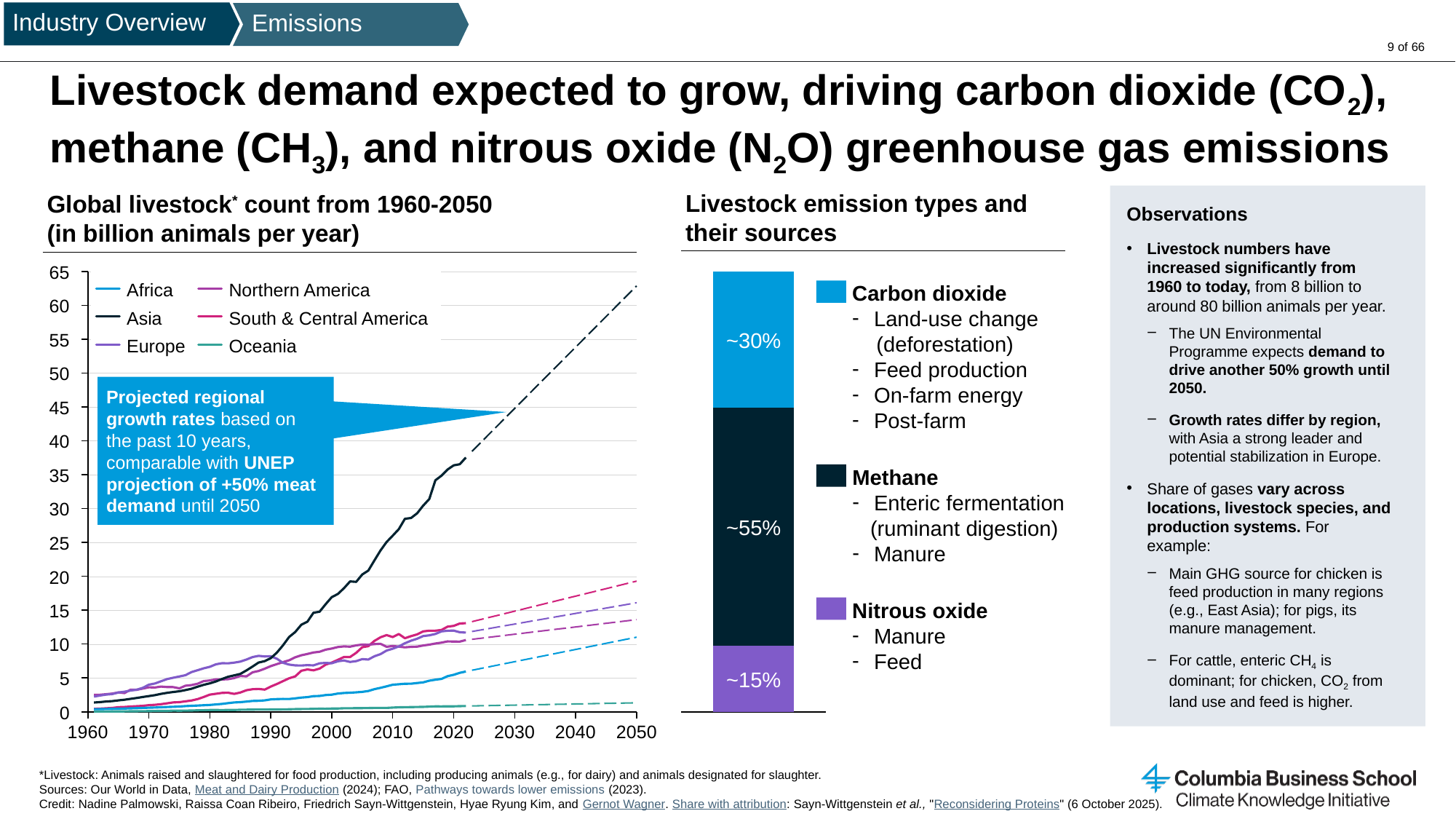
In the 'Global livestock count from 1960-2050' chart, which is larger in 2050: the projected value for Asia or for Africa? Asia In the 'Global livestock count from 1960-2050' chart, how many regions does the legend list? 6 In the 'Global livestock count from 1960-2050' chart, which region has the lowest count across the whole period? Oceania In the 'Global livestock count from 1960-2050' chart, which region has the highest projected count in 2050? Asia In the 'Livestock emission types and their sources' chart, how many emission types are shown in the stacked bar? 3 In the 'Global livestock count from 1960-2050' chart, what kind of chart is it? line chart In the 'Global livestock count from 1960-2050' chart, is the projected value for Asia in 2050 greater or less than 60? greater In the 'Livestock emission types and their sources' chart, which emission type has the smallest share? Nitrous oxide In the 'Livestock emission types and their sources' chart, what share is shown for methane? ~55% In the 'Global livestock count from 1960-2050' chart, is the projected value for Oceania in 2050 greater or less than 5? less In the 'Global livestock count from 1960-2050' chart, does the Asia line rise or fall from 1960 to 2050? rise In the 'Livestock emission types and their sources' chart, what share is shown for carbon dioxide? ~30%